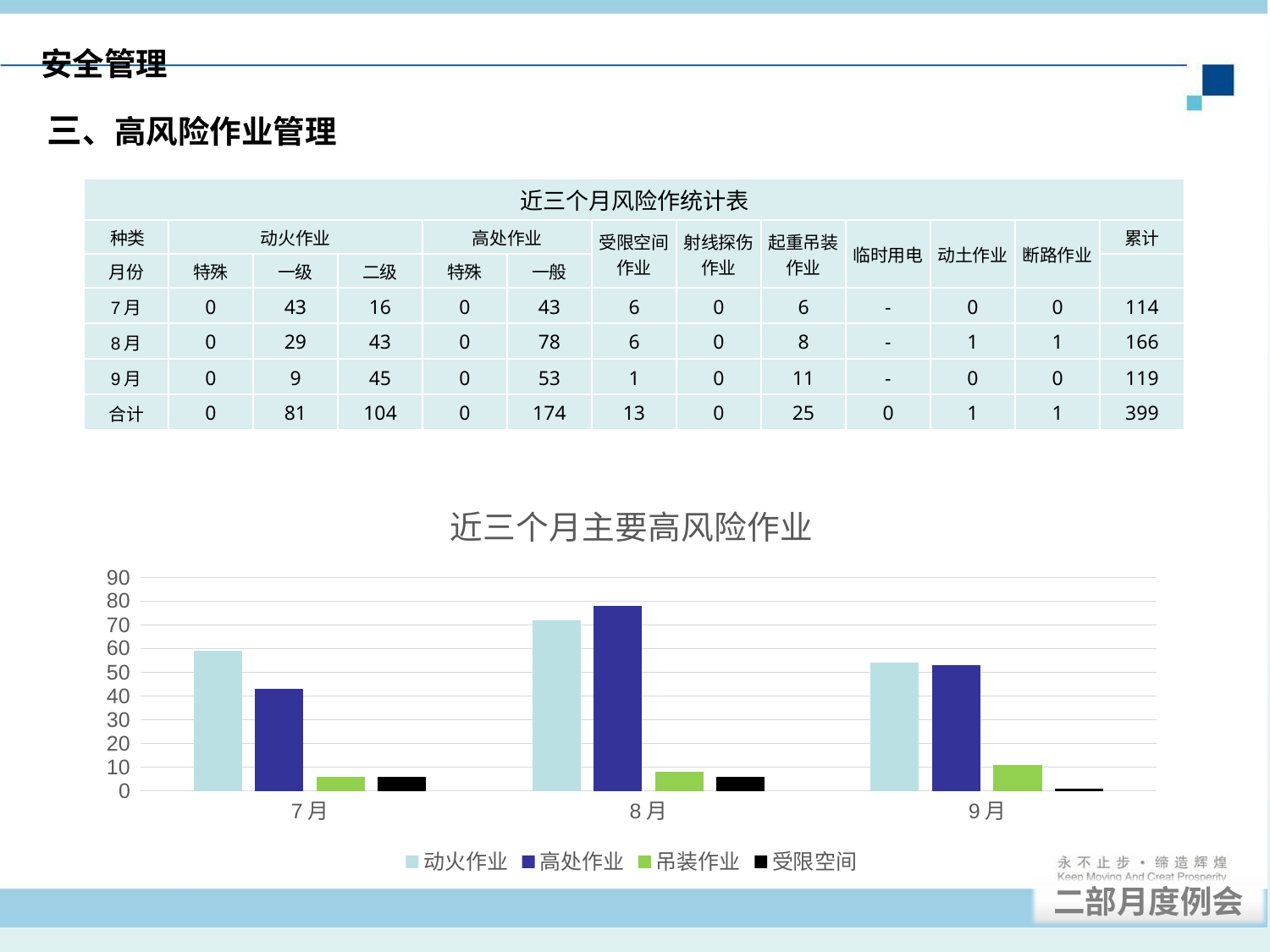
In the chart 近三个月主要高风险作业, which month has the highest 高处作业 bar? 8月 In the chart 近三个月主要高风险作业, is the value for 高处作业 in 7月 greater or less than 50? less What kind of chart is shown under the title 近三个月主要高风险作业? bar chart In the chart 近三个月主要高风险作业, which is larger in 8月: 动火作业 or 高处作业? 高处作业 In the chart 近三个月主要高风险作业, is the value for 动火作业 in 8月 greater or less than 60? greater In the chart 近三个月主要高风险作业, which is larger in 7月: 动火作业 or 高处作业? 动火作业 How many series does the legend of the chart 近三个月主要高风险作业 list? 4 In the chart 近三个月主要高风险作业, is the value for 受限空间 in 7月 greater or less than 10? less In the chart 近三个月主要高风险作业, does the 高处作业 value rise or fall from 7月 to 8月? rise How many months are shown on the x axis of the chart 近三个月主要高风险作业? 3 In the chart 近三个月主要高风险作业, which month has the lowest 受限空间 bar? 9月 What is the title of the bar chart on the slide? 近三个月主要高风险作业